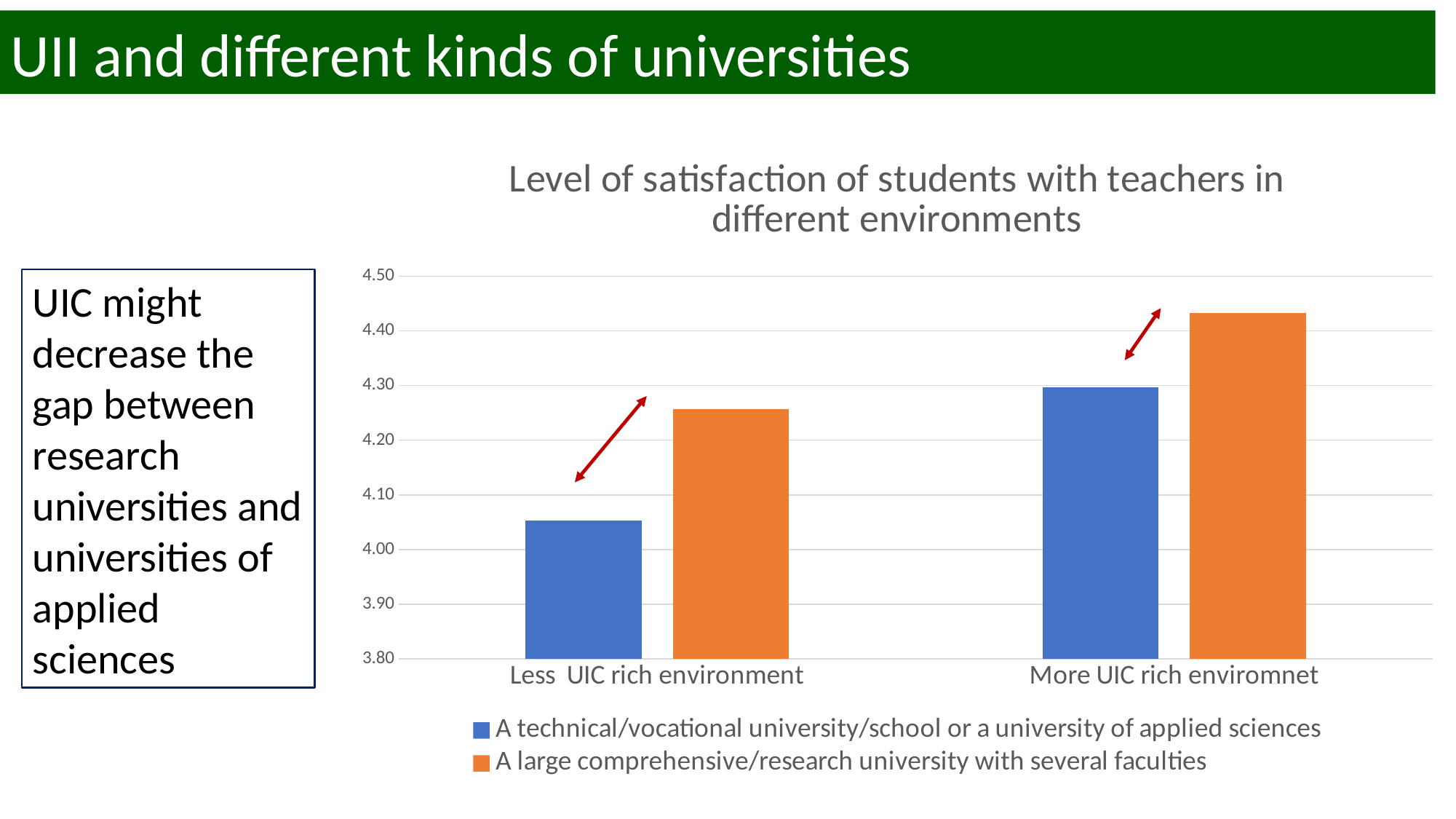
Which bar is the lowest in the chart? A technical/vocational university/school or a university of applied sciences, Less UIC rich environment How many series does the legend list? 2 What is the title of the chart? Level of satisfaction of students with teachers in different environments In the Less UIC rich environment category, which series has the larger value? A large comprehensive/research university with several faculties What kind of chart is shown on the slide? Bar chart Is the value for a large comprehensive/research university with several faculties in the Less UIC rich environment greater or less than 4.30? less Is the value for a large comprehensive/research university with several faculties in the More UIC rich enviromnet greater or less than 4.40? greater Which bar is the highest in the chart? A large comprehensive/research university with several faculties, More UIC rich enviromnet In the More UIC rich enviromnet category, which series has the larger value? A large comprehensive/research university with several faculties Do the values for a technical/vocational university/school or a university of applied sciences rise or fall from the Less UIC rich environment to the More UIC rich enviromnet? rise Is the value for a technical/vocational university/school or a university of applied sciences in the Less UIC rich environment greater or less than 4.10? less How many categories are shown on the x axis? 2